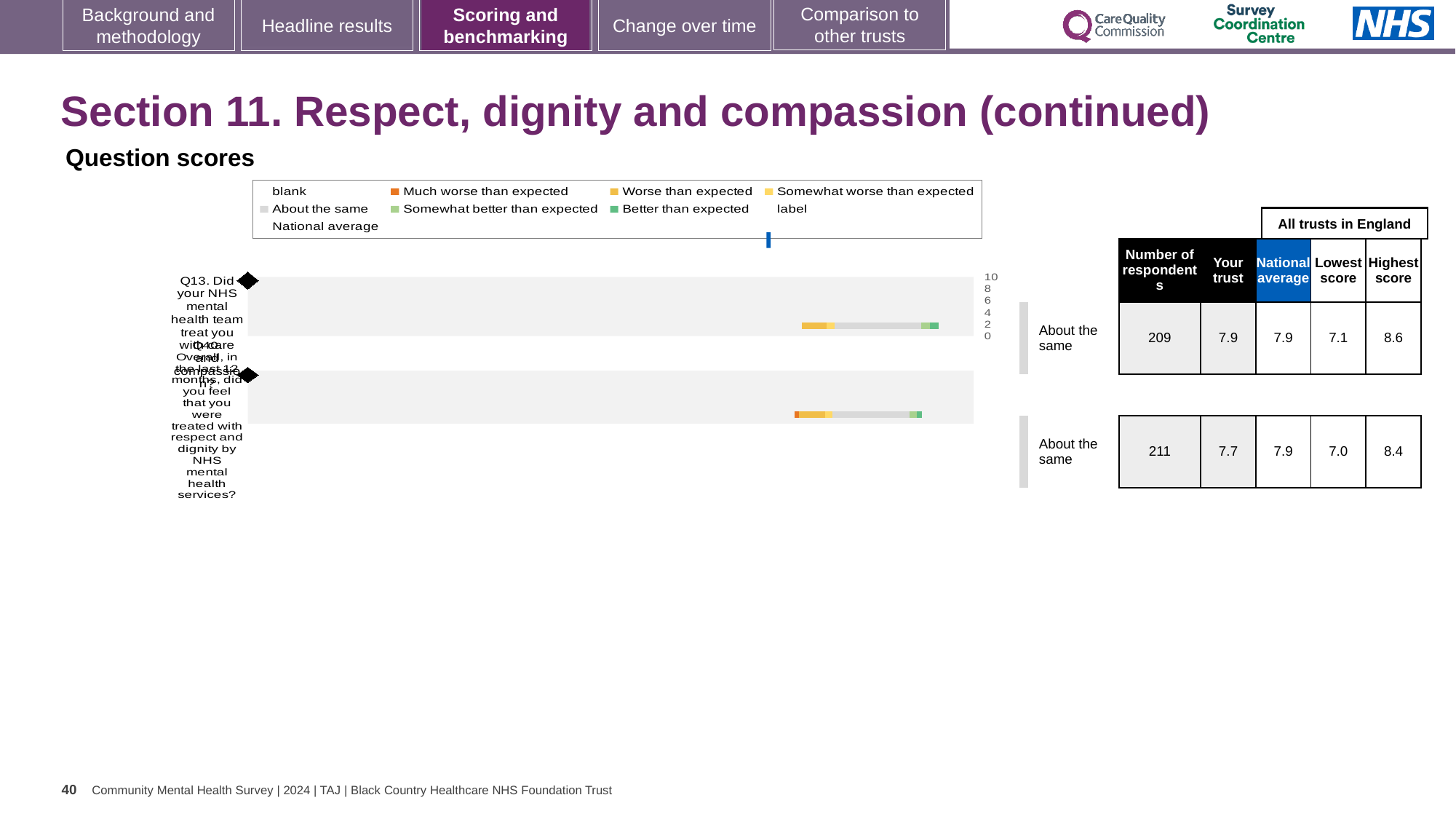
What colour does the chart legend use for 'Much worse than expected'? orange Which benchmark category is shown for Q13 in the question scores chart? About the same In the table beside the chart, what is the lowest score across all trusts in England for Q40? 7.0 Which question has the higher 'Your trust' score in the table beside the chart, Q13 or Q40? Q13 What kind of chart is used to show the question scores for Q13 and Q40? bar chart Which benchmark category is shown for Q40 in the question scores chart? About the same In the table beside the chart, what is the difference between the highest and lowest score for Q13? 1.5 In the table beside the chart, what is the highest score across all trusts in England for Q13? 8.6 In the table beside the chart, what is the 'Your trust' score for Q40? 7.7 How many questions (categories) are plotted in the question scores chart? 2 In the table beside the chart, what is the 'Your trust' score for Q13? 7.9 In the table beside the chart, how many respondents answered Q40? 211